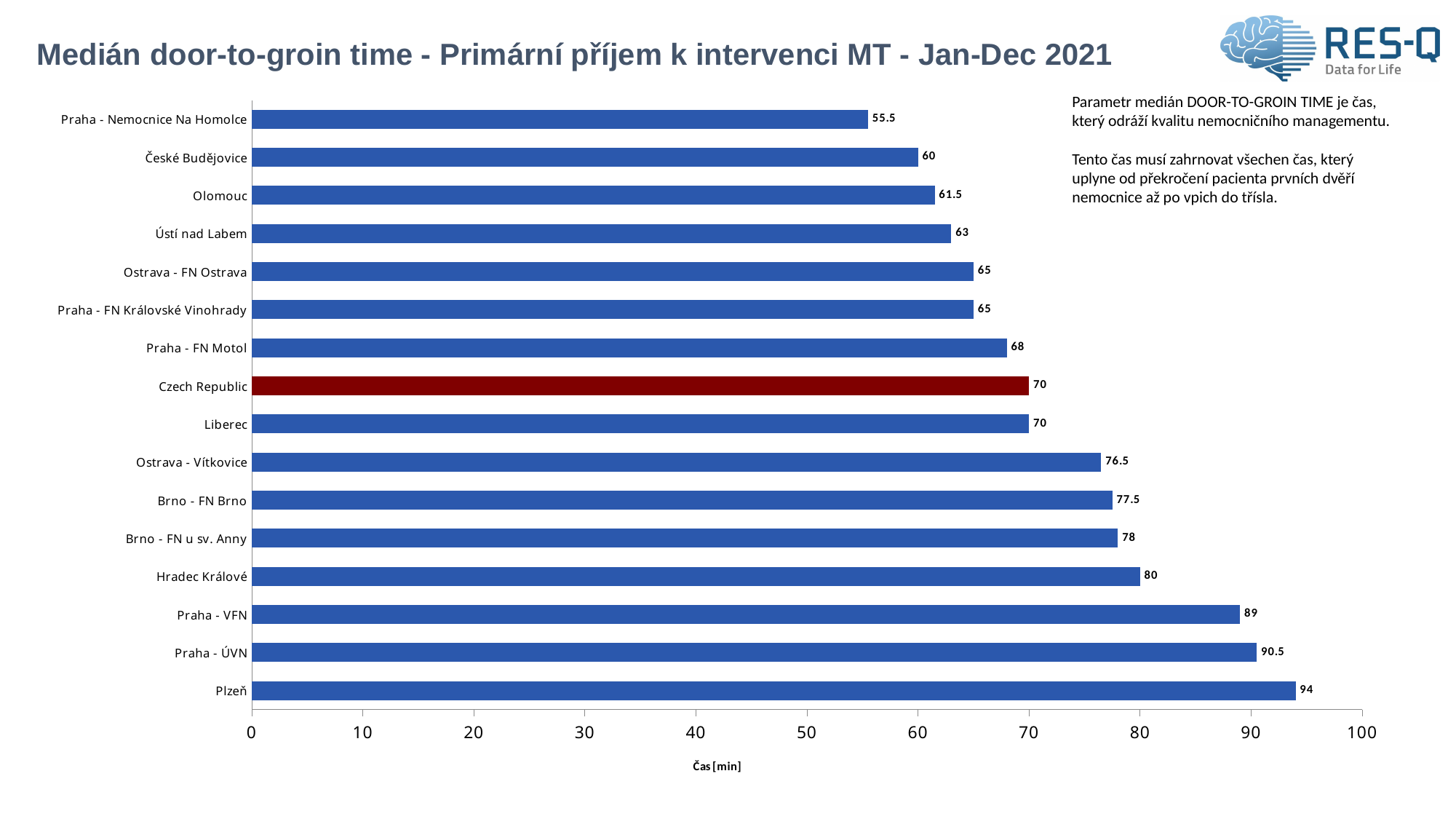
Is the value for Brno - FN Brno greater or less than 70? greater Which category has the highest median door-to-groin time? Plzeň Which category has the lowest median door-to-groin time? Praha - Nemocnice Na Homolce Which bar is coloured dark red instead of blue? Czech Republic How many categories are shown on the chart? 16 Which has a larger value, Hradec Králové or Olomouc? Hradec Králové What is the value shown for Czech Republic? 70 What is the difference between the values for Praha - ÚVN and Praha - VFN? 1.5 What is the value for Praha - Nemocnice Na Homolce? 55.5 What kind of chart is shown on the slide? bar chart What is the label of the x axis? Čas [min] What is the median door-to-groin time for Plzeň? 94